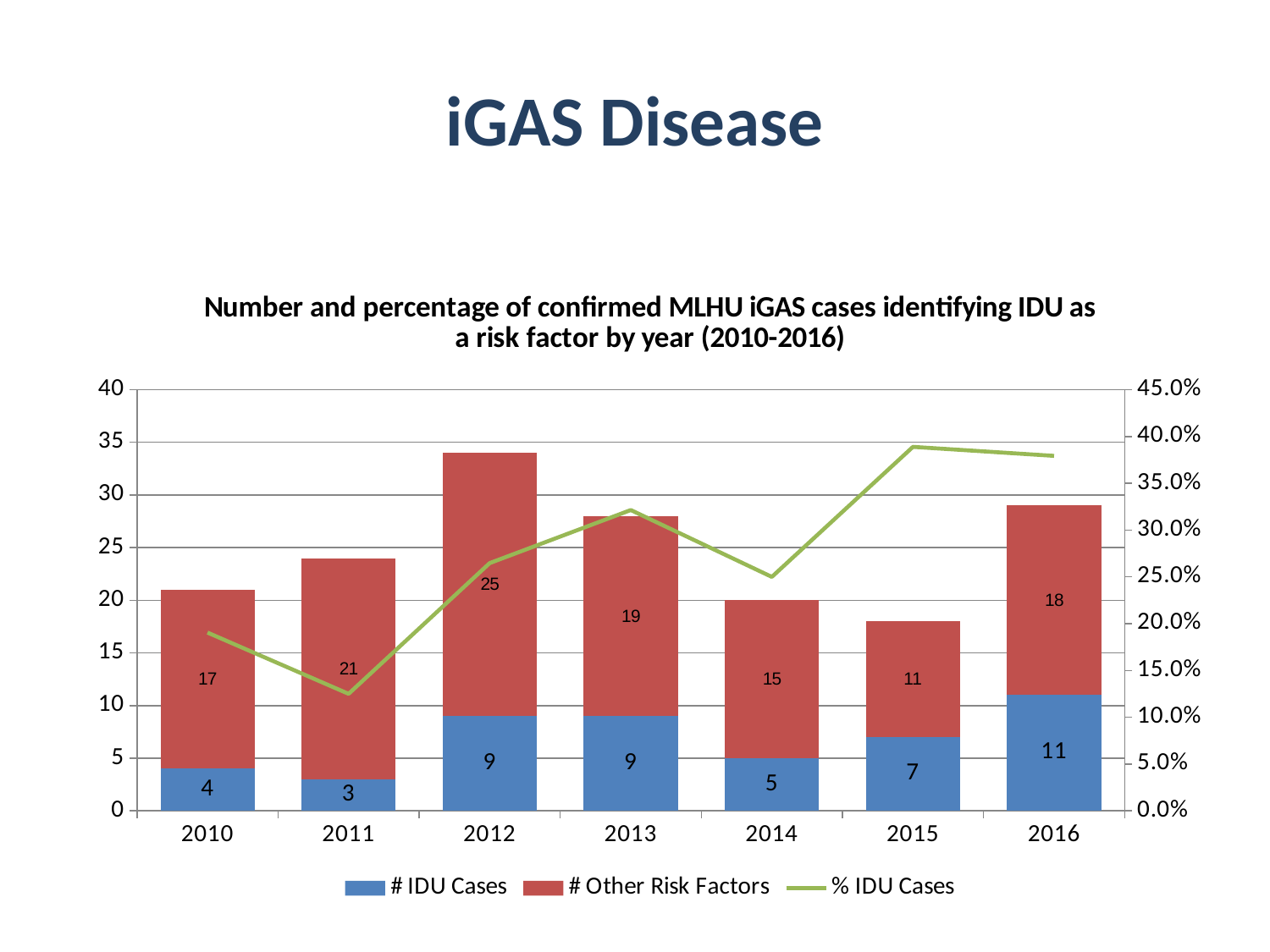
What is the number of other risk factor cases in 2012? 25 Which year has the lowest number of IDU cases? 2011 What is the total height of the stacked bar for 2012? 34 How many IDU cases were there in 2016? 11 How many years are shown on the x axis? 7 Which year has the highest number of IDU cases? 2016 Does the % IDU Cases line rise or fall from 2013 to 2014? fall Which year has the lowest number of other risk factor cases? 2015 What is the difference between the number of other risk factor cases in 2012 and in 2015? 14 Which is larger, the number of IDU cases in 2014 or in 2015? 2015 How many series does the legend list? 3 Is the % IDU Cases value for 2015 greater or less than 35.0%? greater